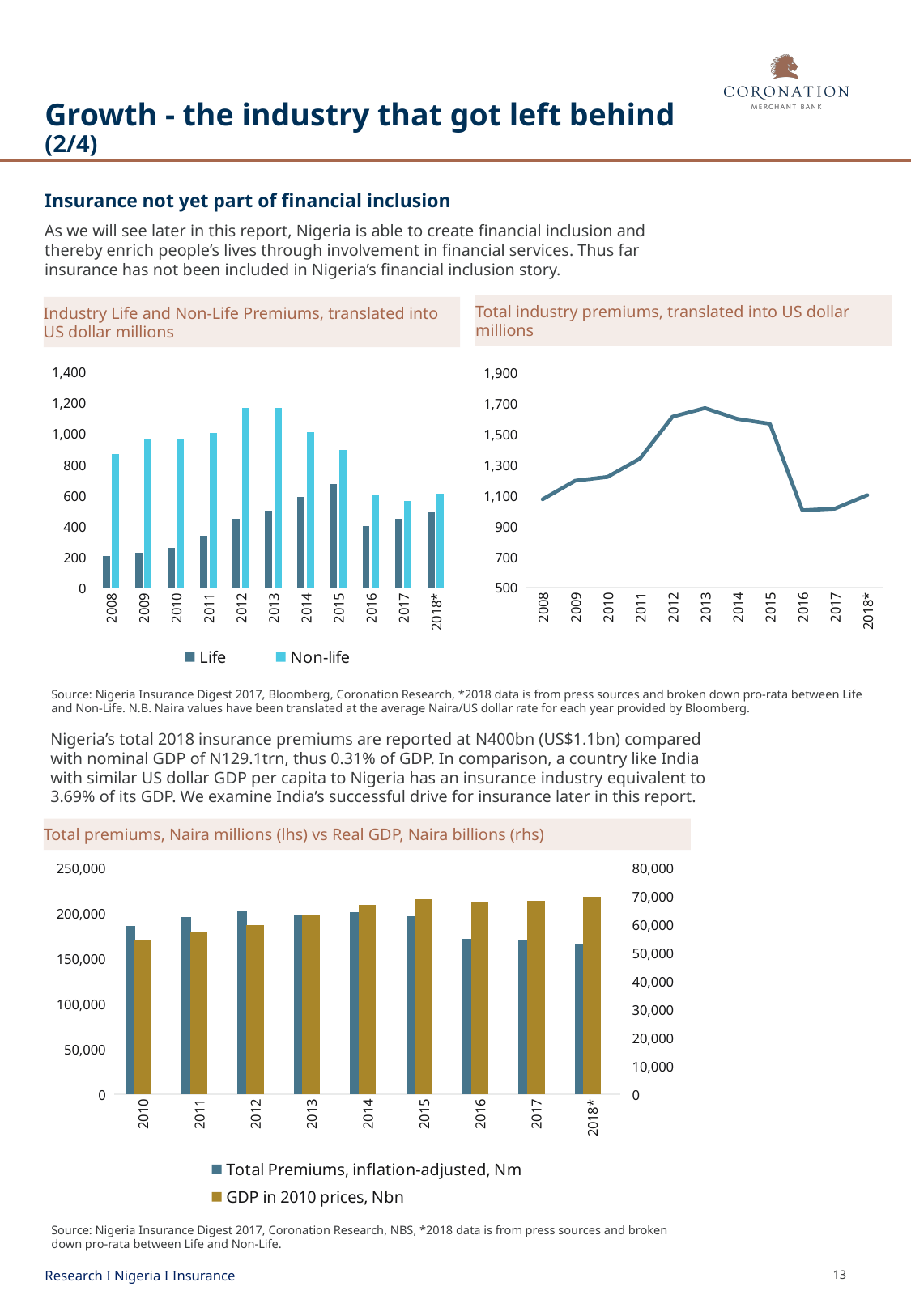
In the 'Industry Life and Non-Life Premiums' chart, which year has the highest Life premiums? 2015 In the 'Industry Life and Non-Life Premiums' chart, is the Life value for 2008 greater or less than 400? less How many years are plotted on the 'Total industry premiums, translated into US dollar millions' chart? 11 In the 'Total premiums, Naira millions (lhs) vs Real GDP, Naira billions (rhs)' chart, which year has the lowest GDP in 2010 prices? 2010 In the 'Total industry premiums, translated into US dollar millions' chart, which year has the highest value? 2013 What kind of chart is the 'Industry Life and Non-Life Premiums, translated into US dollar millions' chart? Bar chart How many series does the legend of the 'Industry Life and Non-Life Premiums' chart list? 2 In the 'Total industry premiums, translated into US dollar millions' chart, does the value rise or fall from 2015 to 2016? Fall In the 'Industry Life and Non-Life Premiums' chart, is the Non-life value for 2012 greater or less than 1,000? greater In the 'Total premiums, Naira millions (lhs) vs Real GDP, Naira billions (rhs)' chart, is the Total Premiums value for 2010 greater or less than 150,000? greater What kind of chart is the 'Total industry premiums, translated into US dollar millions' chart? Line chart